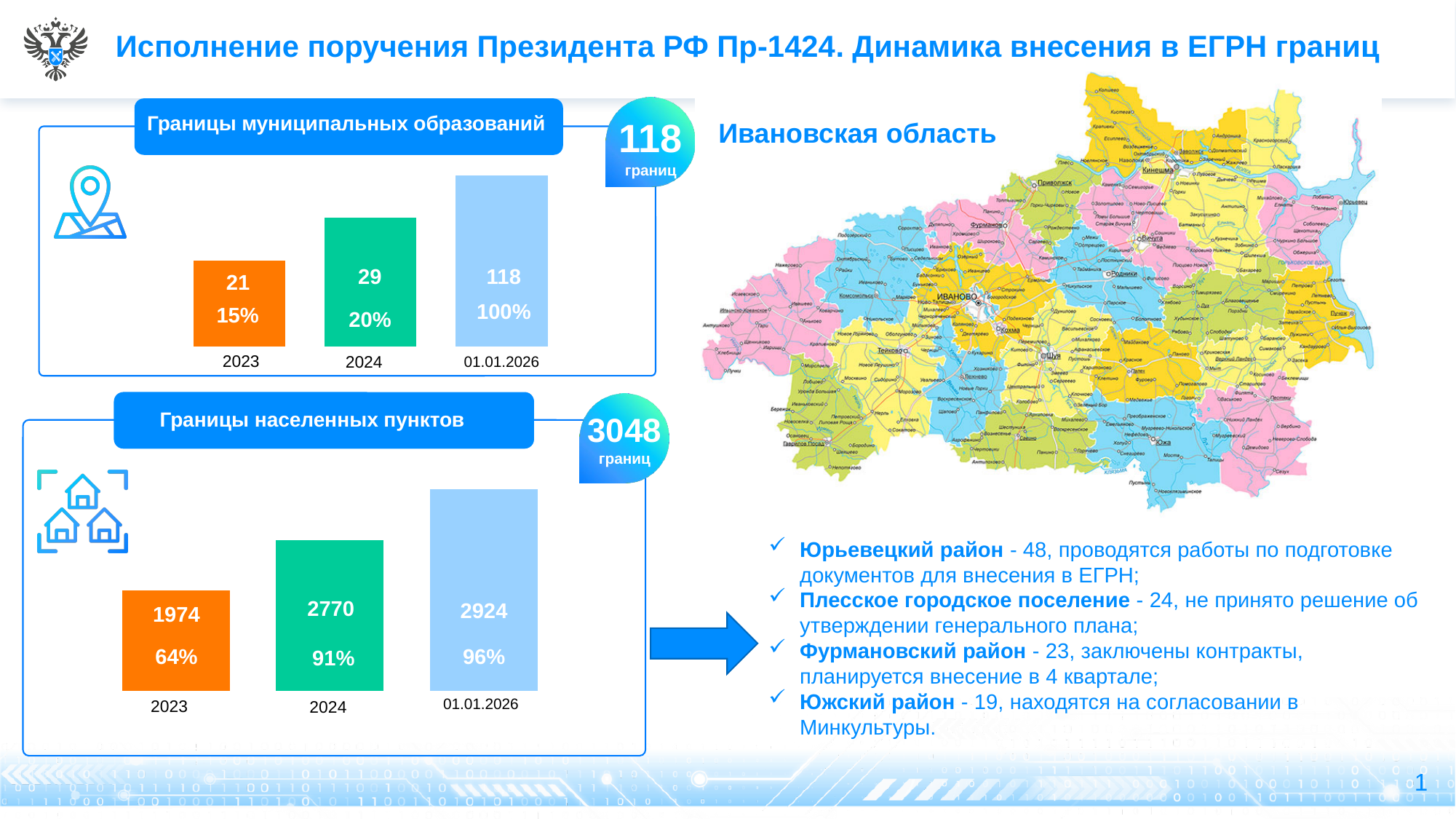
How many categories are shown in the chart titled "Границы муниципальных образований"? 3 In the chart titled "Границы населенных пунктов", which category has the lowest value? 2023 In the chart titled "Границы населенных пунктов", do the values rise or fall from 2023 to 01.01.2026? Rise In the chart titled "Границы муниципальных образований", which category has the highest value? 01.01.2026 In the chart titled "Границы населенных пунктов", what percentage is shown for 2024? 91% In the chart titled "Границы населенных пунктов", which is larger, the value for 2024 or the value for 01.01.2026? 01.01.2026 In the chart titled "Границы муниципальных образований", what is the difference between the values for 01.01.2026 and 2024? 89 In the chart titled "Границы муниципальных образований", what value is shown for 2024? 29 In the chart titled "Границы населенных пунктов", what is the difference between the values for 2024 and 2023? 796 What kind of chart is the chart titled "Границы населенных пунктов"? Bar chart In the chart titled "Границы населенных пунктов", what value is shown for 01.01.2026? 2924 In the chart titled "Границы муниципальных образований", what percentage is shown for 2023? 15%